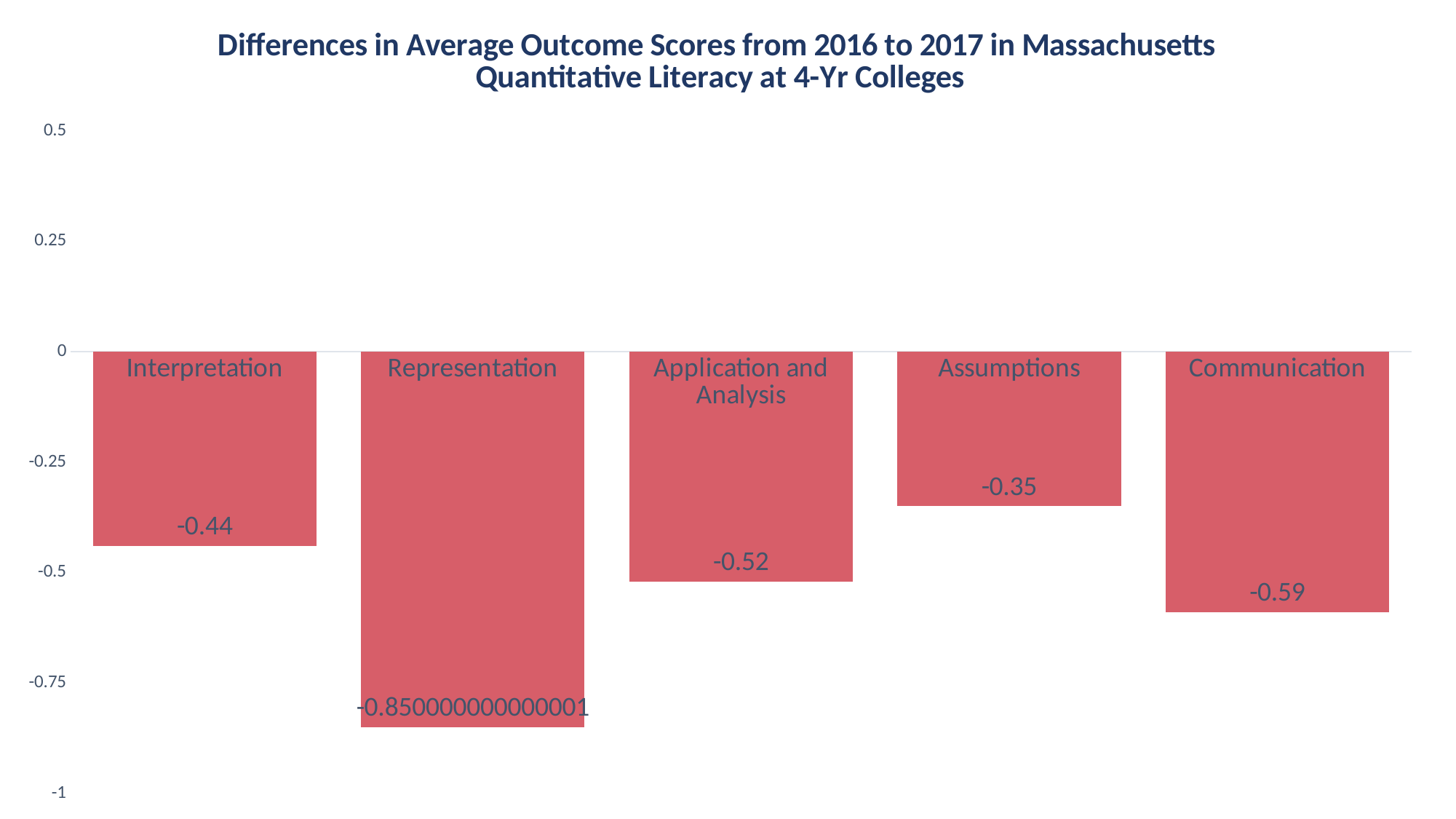
Which category has the lowest value? Representation Is the value for Communication greater or less than -0.5? less What kind of chart is shown on the slide? bar chart What data label is shown on the Representation bar? -0.850000000000001 What is the value for Assumptions? -0.35 What is the value for Interpretation? -0.44 What is the difference between the values for Interpretation and Communication? 0.15 What is the value for Communication? -0.59 Which category has the highest value? Assumptions How many categories are shown in the chart? 5 Which is larger, the value for Application and Analysis or the value for Assumptions? Assumptions What is the value for Application and Analysis? -0.52